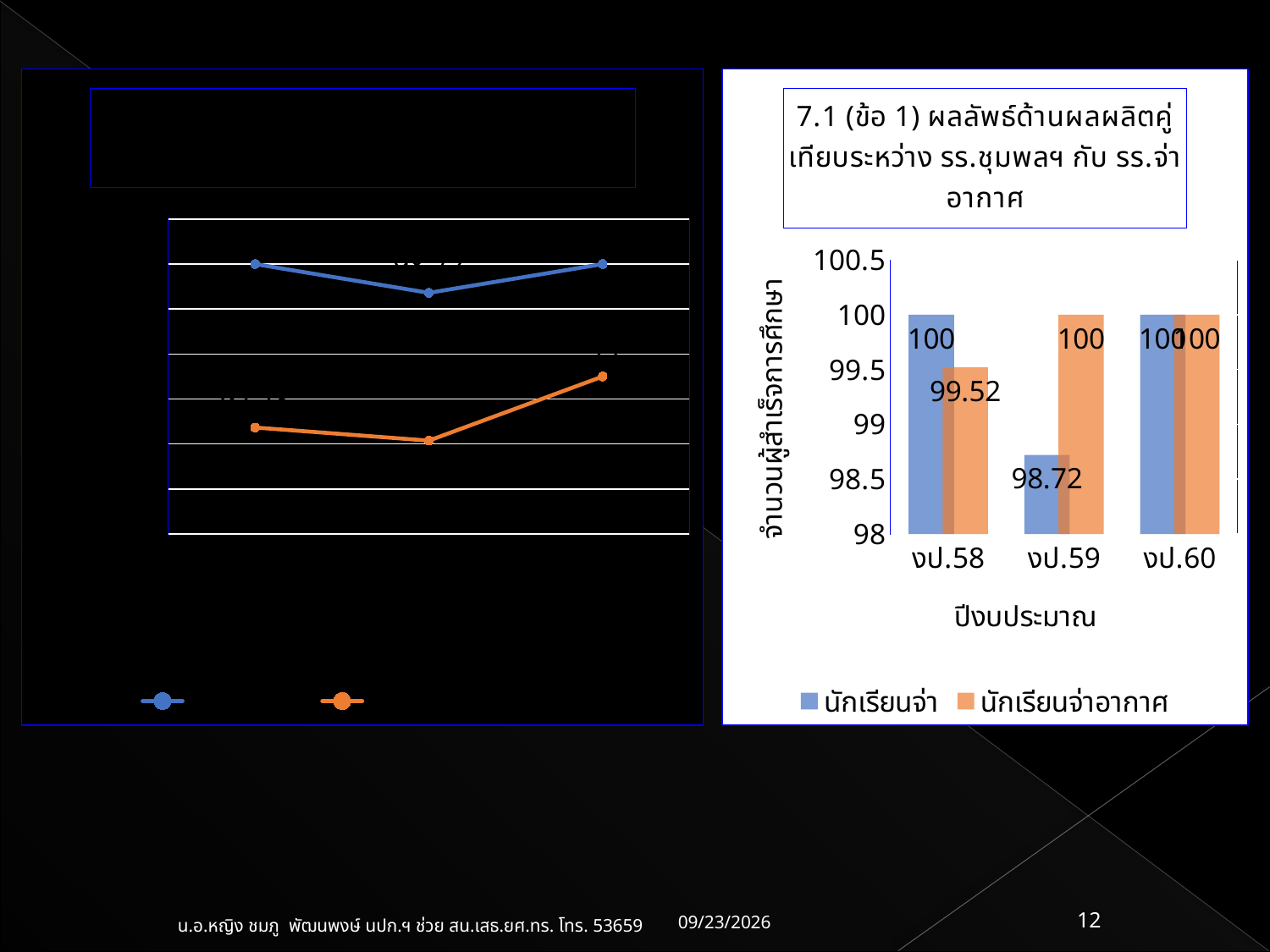
In the right chart, what is the value for นักเรียนจ่าอากาศ in งป.59? 100 In the right chart, what is the value for นักเรียนจ่าอากาศ in งป.58? 99.52 How many years are shown on the x axis of the right chart? 3 In the right chart, what is the difference between นักเรียนจ่าอากาศ and นักเรียนจ่า in งป.59? 1.28 How many series does the legend of the right chart list? 2 In the right chart, what is the value for นักเรียนจ่า in งป.59? 98.72 In the right chart, in which year is the value for นักเรียนจ่า lowest? งป.59 What kind of chart is the chart on the right side of the slide? bar chart What kind of chart is the chart on the left side of the slide? line chart In the right chart, in which year is the value for นักเรียนจ่าอากาศ lowest? งป.58 In the right chart, what is the value for นักเรียนจ่า in งป.58? 100 In the right chart, which series has the larger value in งป.59, นักเรียนจ่า or นักเรียนจ่าอากาศ? นักเรียนจ่าอากาศ